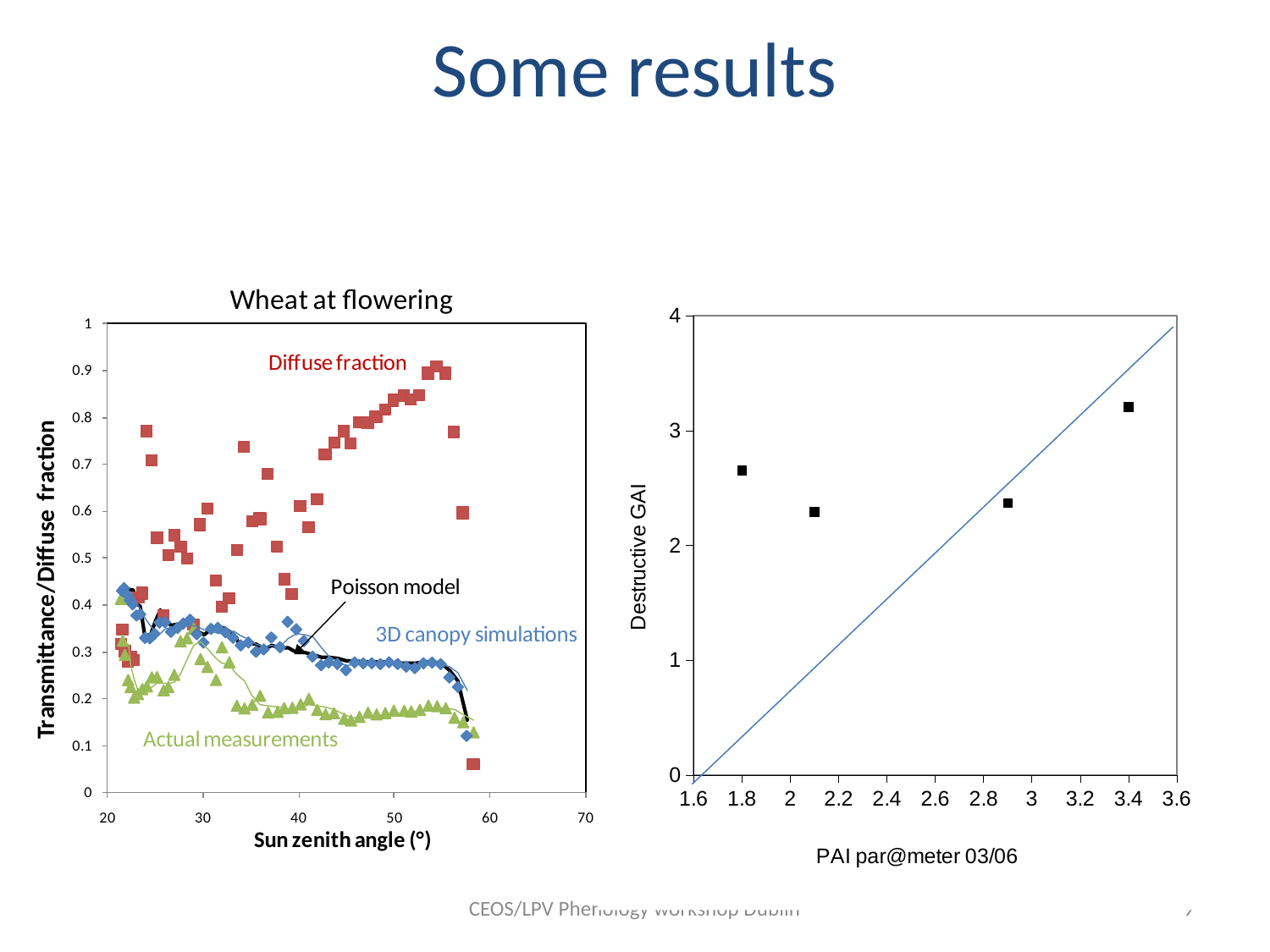
What type of chart is the 'Wheat at flowering' chart on the left? scatter chart On the right-hand chart, at which PAI par@meter 03/06 value is the Destructive GAI highest? 3.4 On the 'Wheat at flowering' chart, is the Actual measurements value at a sun zenith angle of 50 greater or less than 0.3? less On the 'Wheat at flowering' chart, do the Actual measurements generally rise or fall as the sun zenith angle increases? fall What is the y-axis label of the right-hand chart? Destructive GAI On the right-hand chart, is the Destructive GAI for the point at PAI 3.4 greater or less than 3? greater On the 'Wheat at flowering' chart, does the Diffuse fraction generally rise or fall as the sun zenith angle increases from 20 to 55? rise On the 'Wheat at flowering' chart, at a sun zenith angle of 50, which is larger: the Diffuse fraction or the Actual measurements? Diffuse fraction On the 'Wheat at flowering' chart, is the Diffuse fraction value near a sun zenith angle of 54 greater or less than 0.8? greater What is the x-axis label of the 'Wheat at flowering' chart? Sun zenith angle (°) How many data series are labelled on the 'Wheat at flowering' chart? 4 How many data points are plotted on the right-hand chart (Destructive GAI vs PAI par@meter 03/06)? 4